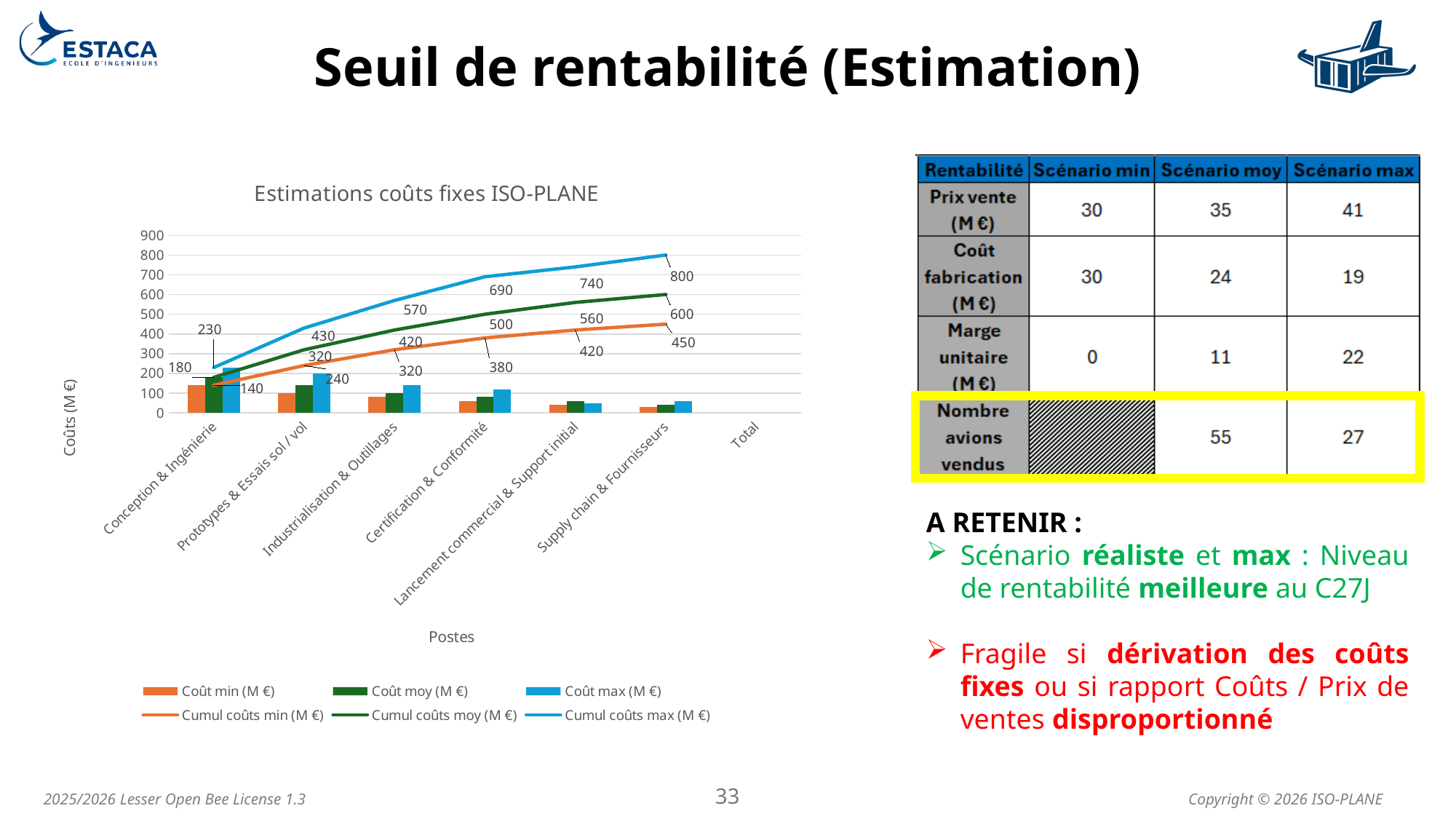
Is the Coût min (M €) bar for Supply chain & Fournisseurs greater or less than 100? less Which is larger: Cumul coûts max (M €) at Certification & Conformité or Cumul coûts moy (M €) at Lancement commercial & Support initial? Cumul coûts max at Certification & Conformité What is the value of Cumul coûts moy (M €) for Certification & Conformité? 500 What is the value of Cumul coûts min (M €) for Supply chain & Fournisseurs? 450 What is the title of the chart on the slide? Estimations coûts fixes ISO-PLANE What kind of chart is shown on the slide? Combined bar and line chart What is the value of Cumul coûts max (M €) for Supply chain & Fournisseurs? 800 What is the value of Cumul coûts max (M €) for Industrialisation & Outillages? 570 How many series does the chart legend list? 6 How many categories are shown on the x axis of the chart? 7 What is the difference between Cumul coûts max (M €) and Cumul coûts min (M €) at Supply chain & Fournisseurs? 350 Do the cumulative cost lines rise or fall from Conception & Ingénierie to Supply chain & Fournisseurs? Rise